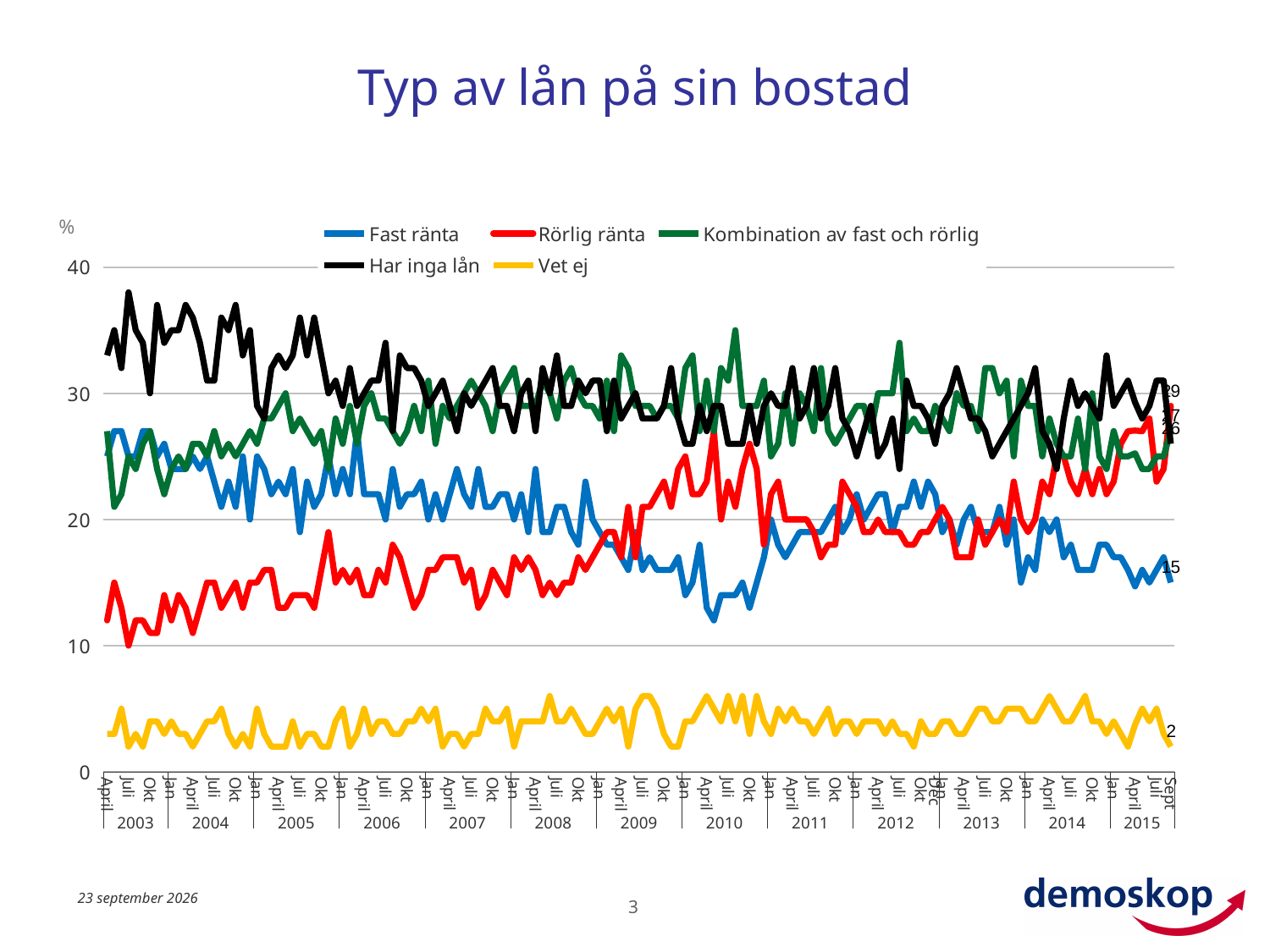
How many series does the legend list? 5 What kind of chart is shown on the slide? line chart At the start of the chart in 2003, which is larger: Fast ränta or Rörlig ränta? Fast ränta What is the title of the chart? Typ av lån på sin bostad What is the final labelled value for Vet ej at the right end of the chart? 2 What is the final labelled value for Har inga lån at the right end of the chart? 26 Is the value for Har inga lån at the start of the chart in 2003 greater or less than 30? greater What is the final labelled value for Fast ränta at the right end of the chart? 15 Does the Fast ränta series rise or fall overall from 2003 to 2015? fall What is the difference between the final labelled values of Har inga lån and Fast ränta? 11 Which series has the lowest value at the right end of the chart? Vet ej Does the Rörlig ränta series rise or fall overall from 2003 to 2015? rise